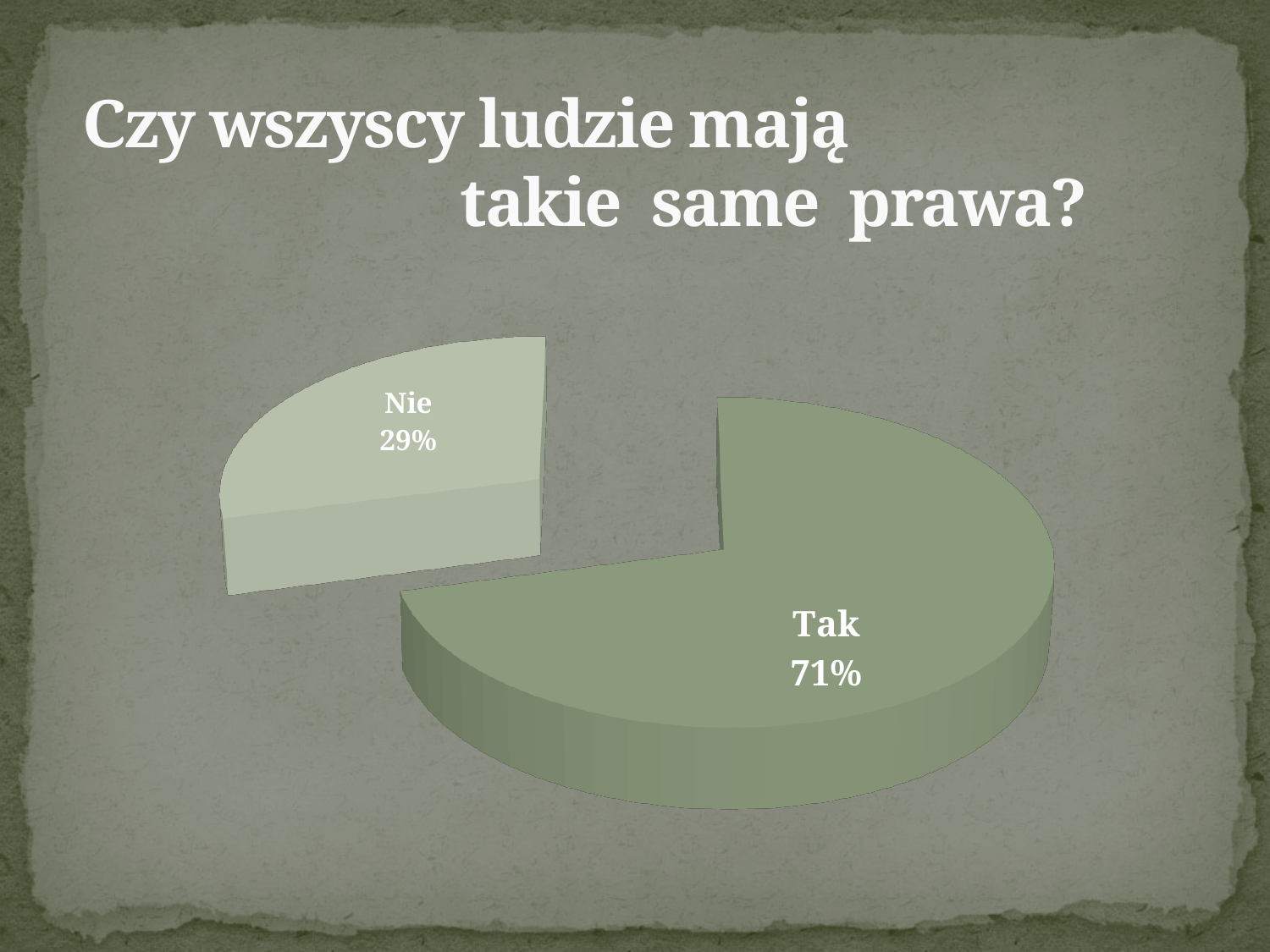
What kind of chart is shown on the slide? Pie chart What is the difference in percentage points between the "Tak" and "Nie" slices? 42 Which slice is pulled out (exploded) from the rest of the pie? Nie How many slices does the pie chart have? 2 Which is larger, the "Tak" slice or the "Nie" slice? Tak What share of the pie does the "Tak" slice represent? 71% What share of the pie does the "Nie" slice represent? 29% What is the title of the slide above the chart? Czy wszyscy ludzie mają takie same prawa? Which slice of the pie is the largest? Tak Which slice of the pie is the smallest? Nie